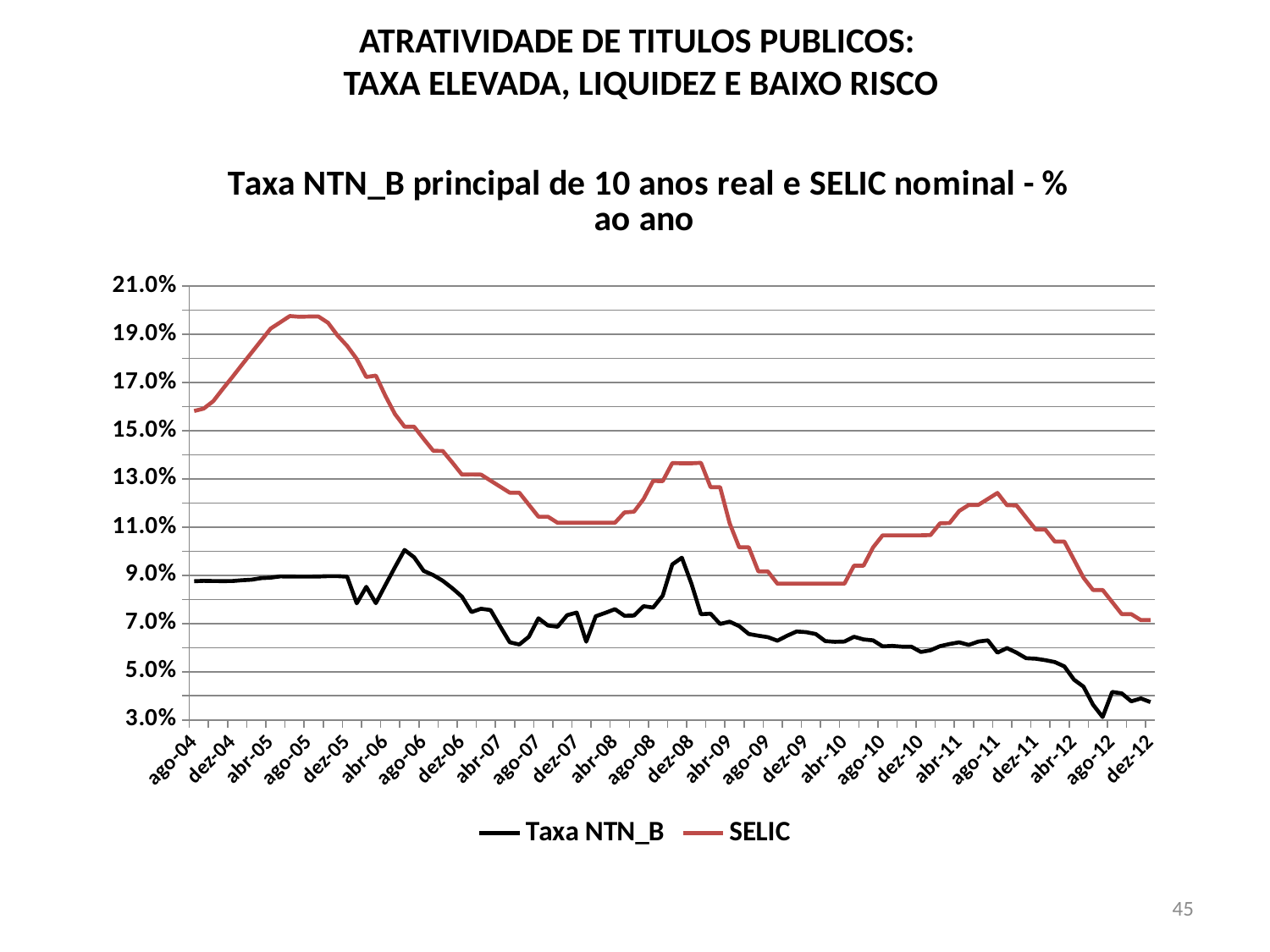
Which series is higher at ago-05, Taxa NTN_B or SELIC? SELIC Is the SELIC value at ago-04 greater or less than 15.0%? greater Is the SELIC value at dez-07 greater or less than 13.0%? less What kind of chart is shown on the slide? line chart Does the Taxa NTN_B line rise or fall between abr-11 and dez-12? fall Does the SELIC line rise or fall between ago-04 and ago-05? rise Is the SELIC value at ago-05 greater or less than 19.0%? greater Which series is drawn in red? SELIC What are the two series named in the legend? Taxa NTN_B and SELIC How many series does the legend list? 2